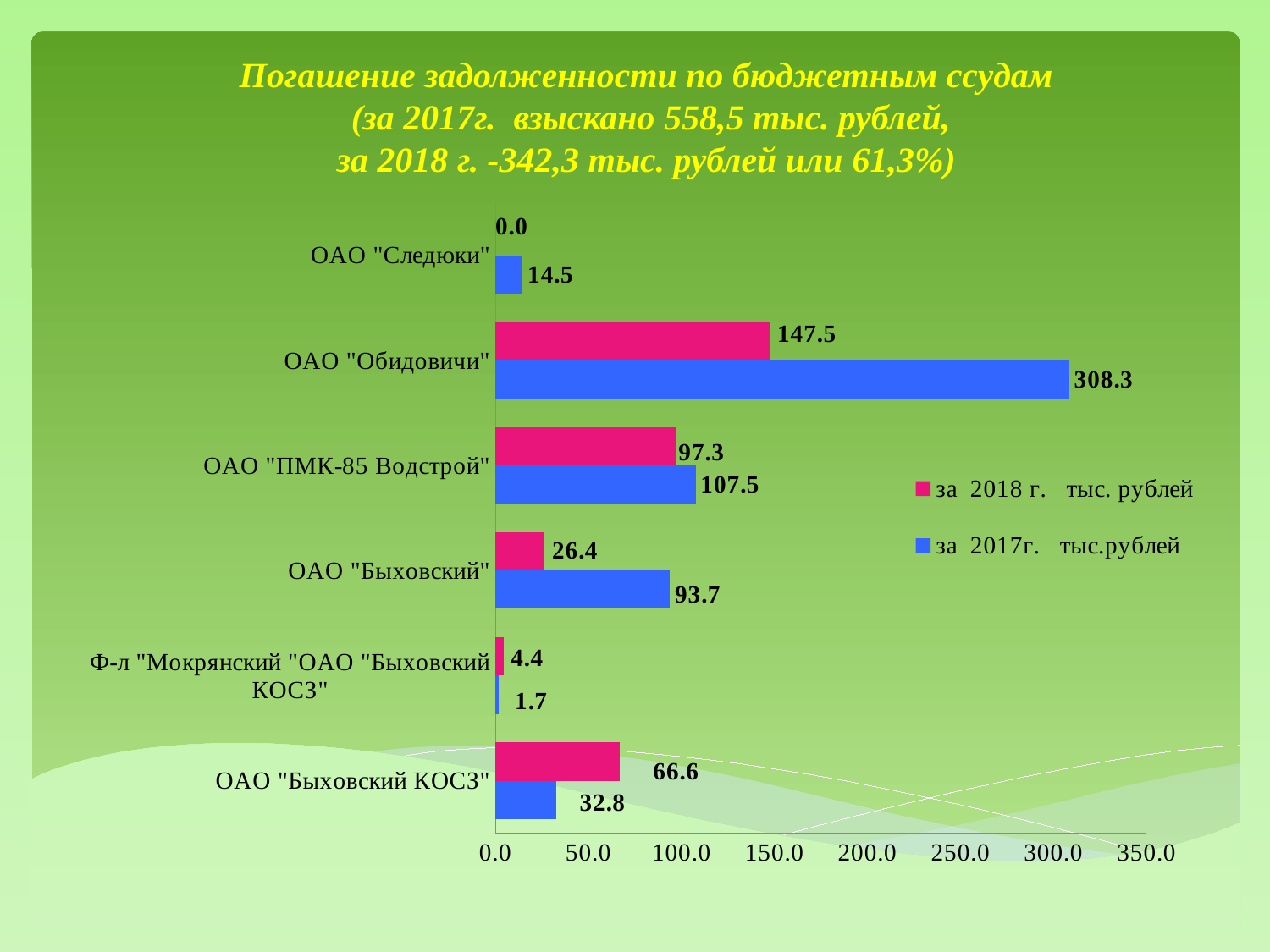
What is the difference between the 2017 and 2018 values for ОАО "Быховский"? 67.3 Which organisation has the highest value for 2017 (за 2017г.)? ОАО "Обидовичи" What is the value for ОАО "Следюки" for 2018 (за 2018 г.)? 0.0 Which organisation has the lowest value for 2017 (за 2017г.)? Ф-л "Мокрянский "ОАО "Быховский КОСЗ" How many organisations (categories) are shown on the chart? 6 What is the value for ОАО "Обидовичи" for 2017 (за 2017г.)? 308.3 What is the value for ОАО "ПМК-85 Водстрой" for 2018 (за 2018 г.)? 97.3 How many series does the legend list? 2 Which colour represents the series "за 2018 г. тыс. рублей"? Pink Is the 2017 value for ОАО "Обидовичи" greater or less than 300.0? greater What kind of chart is shown on the slide? Bar chart For ОАО "Быховский КОСЗ", which is larger: the 2018 value or the 2017 value? The 2018 value (66.6)